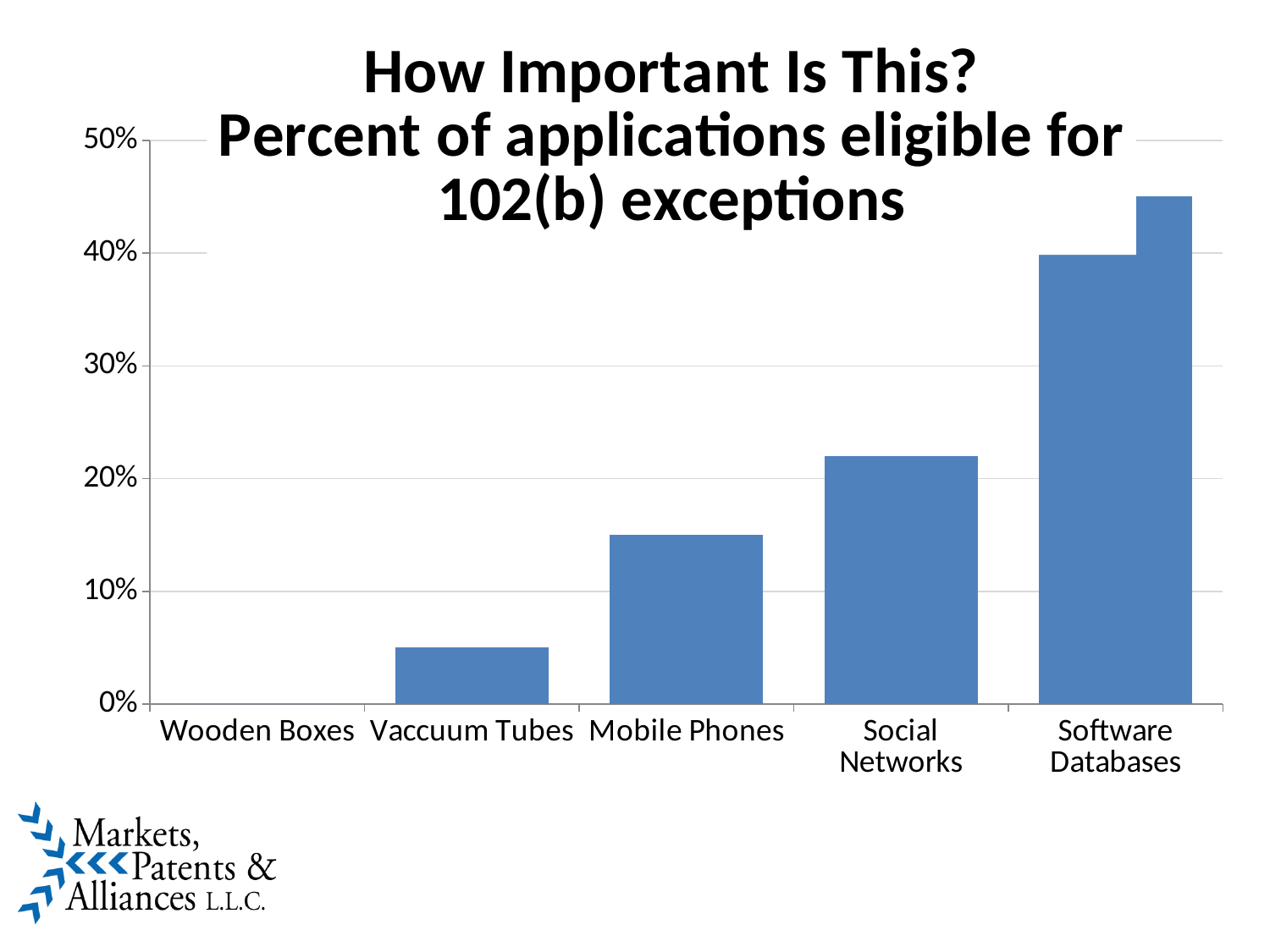
Is the value for Vaccuum Tubes greater or less than 10%? less Is the value for Mobile Phones greater or less than 10%? greater Do the values rise or fall moving from left to right along the x axis? rise What is the title of the chart? How Important Is This? Percent of applications eligible for 102(b) exceptions Which category has the lowest percent of applications eligible for 102(b) exceptions? Wooden Boxes Which is larger, the value for Social Networks or the value for Mobile Phones? Social Networks Which category has the highest percent of applications eligible for 102(b) exceptions? Software Databases How many categories are shown on the x axis of the chart? 5 Is the value for Social Networks greater or less than 30%? less What is the highest value shown on the y axis of the chart? 50% What type of chart is shown on the slide? bar chart